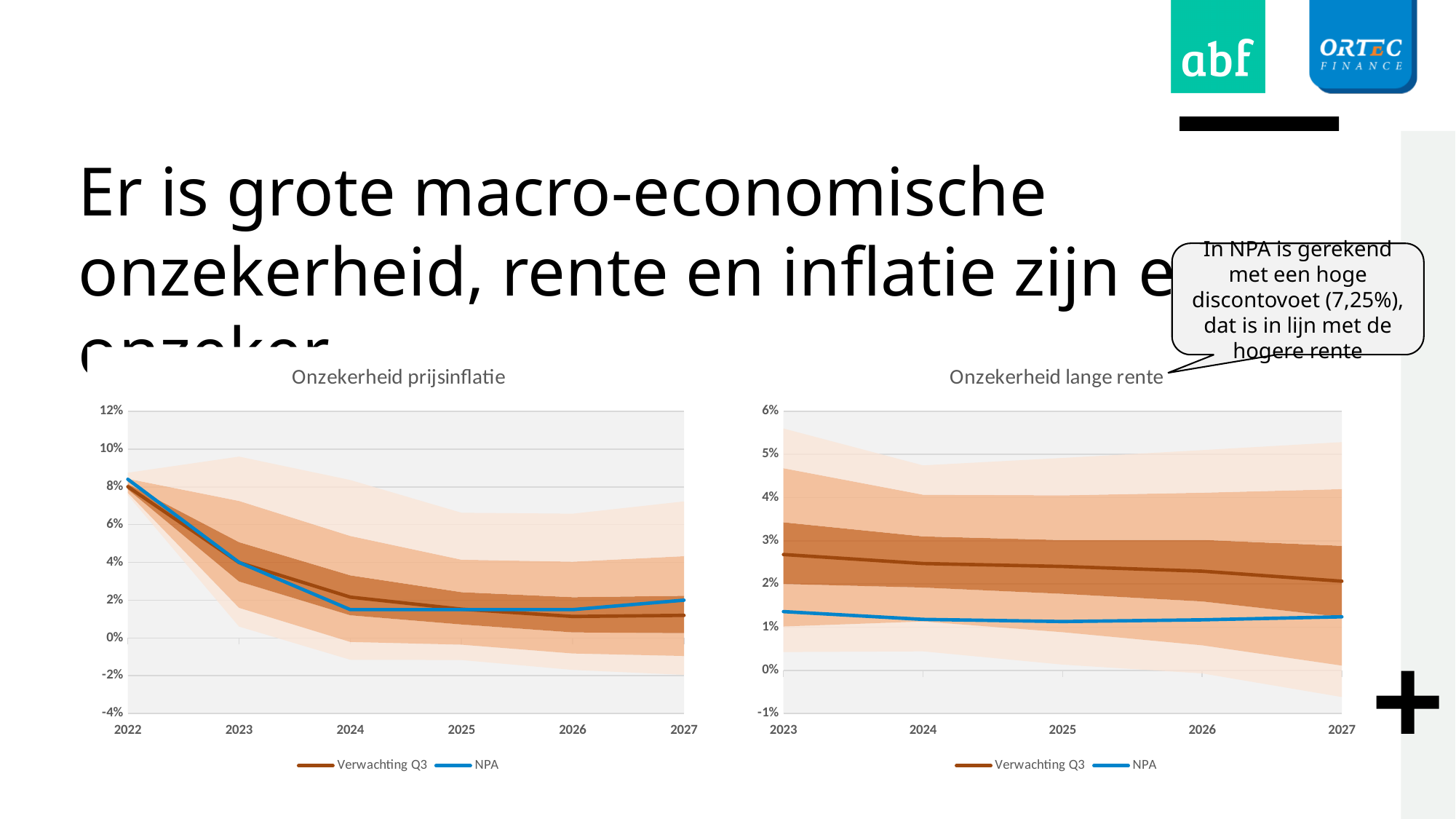
In the 'Onzekerheid lange rente' chart, is the NPA value for 2023 greater or less than 2%? less In the 'Onzekerheid prijsinflatie' chart, is the NPA value for 2022 greater or less than 6%? greater In the 'Onzekerheid prijsinflatie' chart, which series has the higher value in 2027, Verwachting Q3 or NPA? NPA In the 'Onzekerheid lange rente' chart, which series has the higher value in 2025, Verwachting Q3 or NPA? Verwachting Q3 How many years are shown on the x axis of the 'Onzekerheid prijsinflatie' chart? 6 In the 'Onzekerheid prijsinflatie' chart, is the Verwachting Q3 value for 2024 greater or less than 4%? less In the 'Onzekerheid prijsinflatie' chart, does the NPA line rise or fall from 2022 to 2024? fall How many years are shown on the x axis of the 'Onzekerheid lange rente' chart? 5 Which series are listed in the legend of the 'Onzekerheid prijsinflatie' chart? Verwachting Q3 and NPA How many series does the legend of the 'Onzekerheid lange rente' chart list? 2 What kind of chart is the 'Onzekerheid prijsinflatie' chart? combination area and line chart